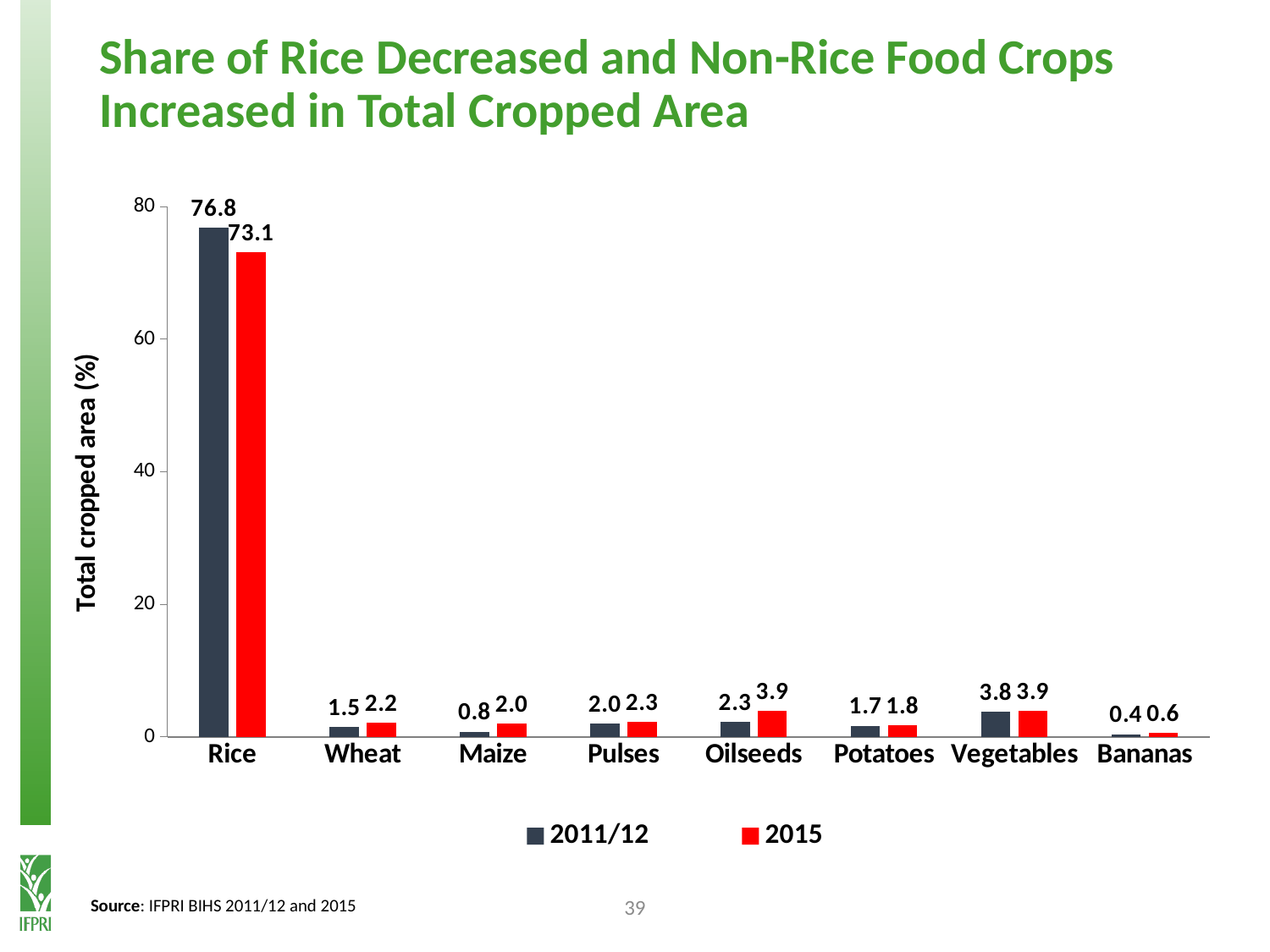
What is the value for Rice in 2011/12? 76.8 What is the value for Maize in 2011/12? 0.8 Which crop has the highest share of total cropped area in 2015? Rice How many series does the legend list? 2 What is the value for Oilseeds in 2015? 3.9 Which crop has the lowest share of total cropped area in 2011/12? Bananas Is the value for Rice in 2015 greater or less than 60? greater What kind of chart is shown on the slide? Bar chart What is the difference between the Oilseeds values for 2015 and 2011/12? 1.6 How many crop categories are shown on the x axis? 8 What is the difference between the Rice values for 2011/12 and 2015? 3.7 Which is larger, the 2015 value for Wheat or the 2015 value for Maize? Wheat